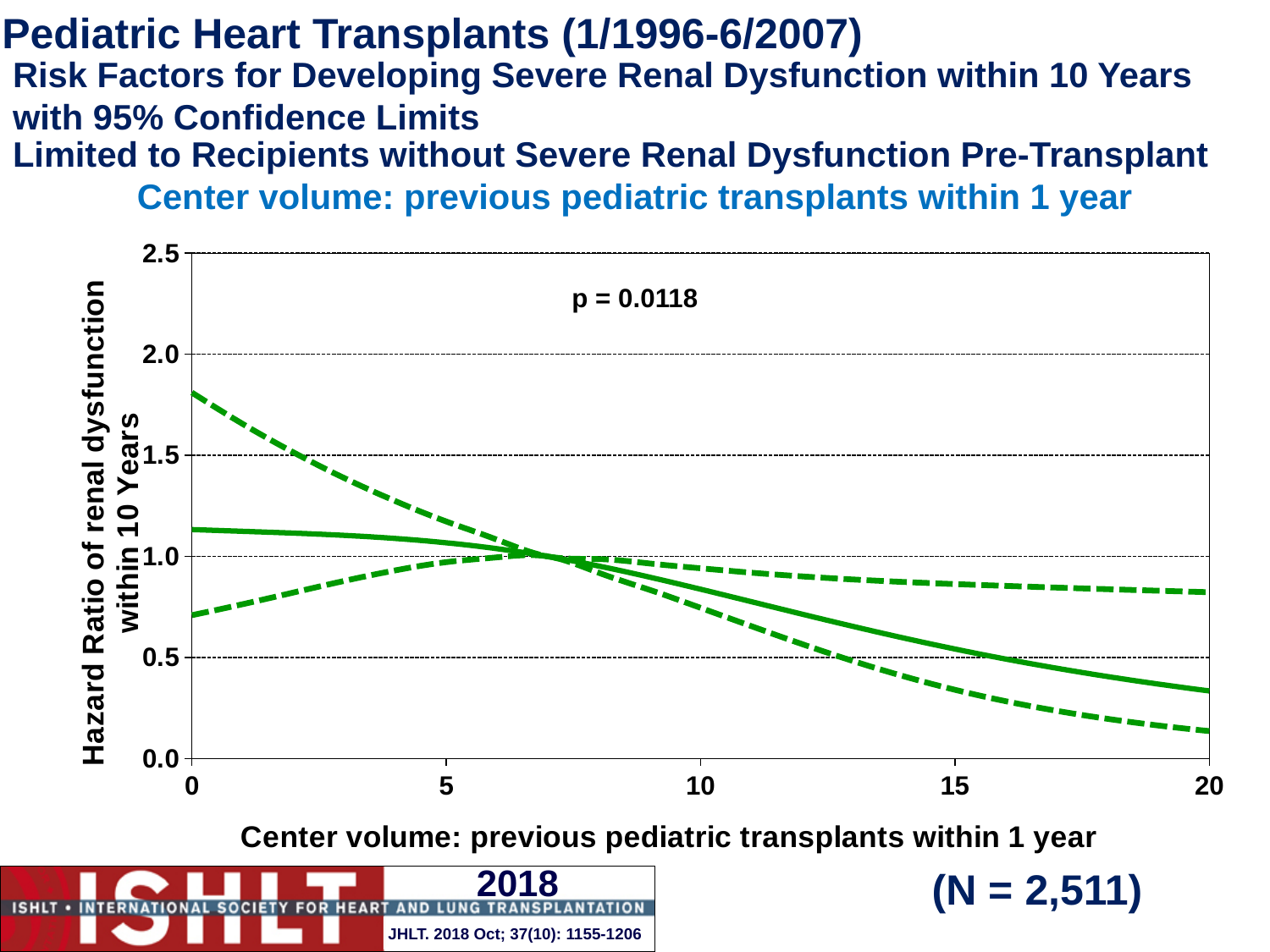
What kind of chart is shown on the slide? line chart Is the upper dashed confidence limit at a center volume of 20 greater or less than 1.0? less What p-value is printed on the chart? p = 0.0118 What is the label of the x axis? Center volume: previous pediatric transplants within 1 year Is the solid hazard ratio line at a center volume of 20 greater or less than 0.5? less Is the solid hazard ratio line at a center volume of 0 greater or less than 1.0? greater Does the solid hazard ratio line rise or fall as center volume increases from 0 to 20? fall How many lines are plotted on the chart? 3